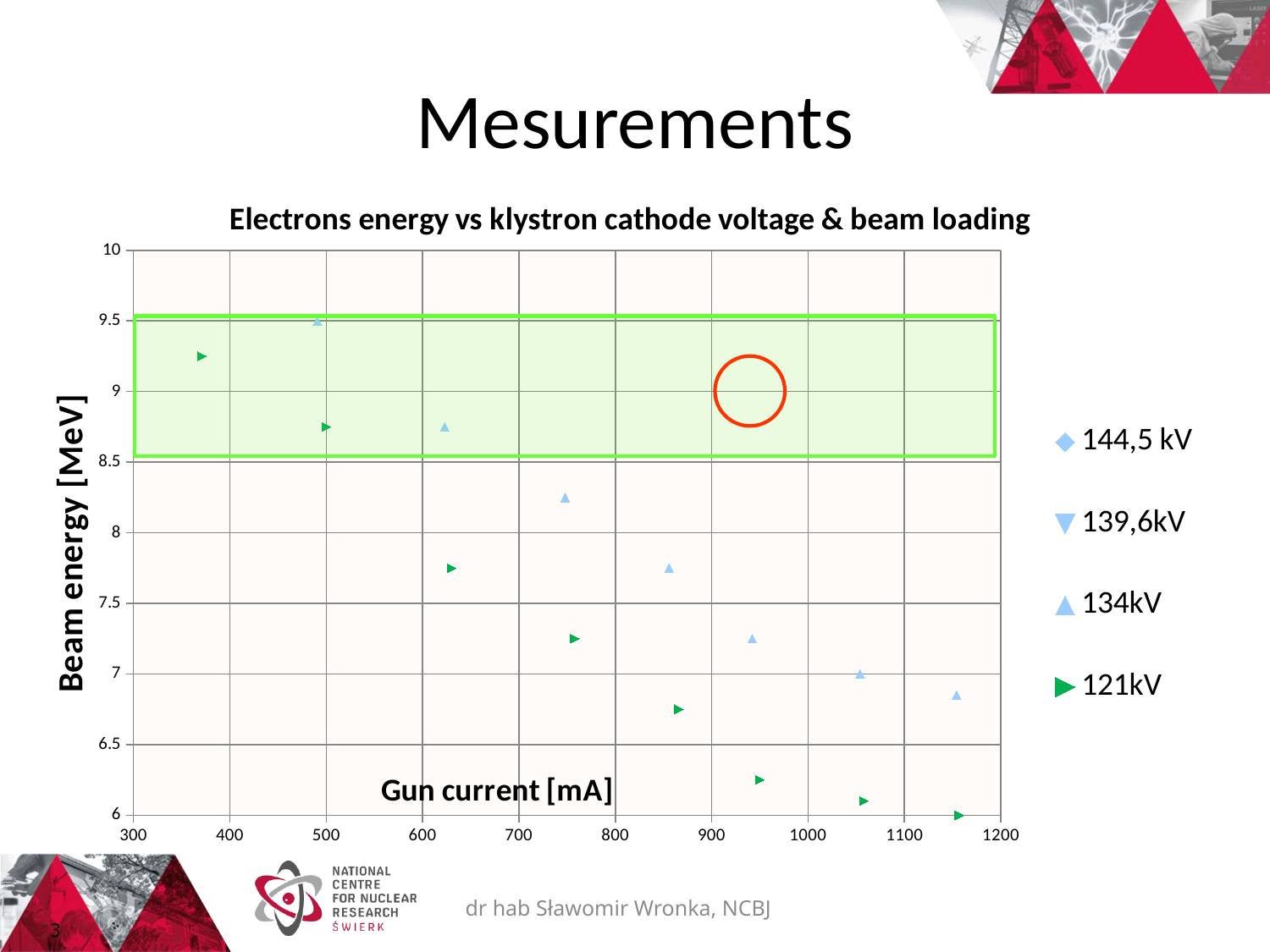
What kind of chart is shown on the slide? scatter chart Is the beam energy of the 121kV point at about 1150 mA greater or less than 6.5 MeV? less What is the title of the chart? Electrons energy vs klystron cathode voltage & beam loading As gun current increases along the x axis, does the beam energy for the 121kV series rise or fall? fall Is the beam energy of the 121kV point at about 370 mA greater or less than 9 MeV? greater As gun current increases along the x axis, does the beam energy for the 134kV series rise or fall? fall Is the beam energy of the 134kV point at about 1150 mA greater or less than 7.5 MeV? less At a gun current of about 860 mA, which series has the higher beam energy, 134kV or 121kV? 134kV What is the label of the y axis? Beam energy [MeV] How many data points are plotted for the 121kV series? 8 How many series does the legend list? 4